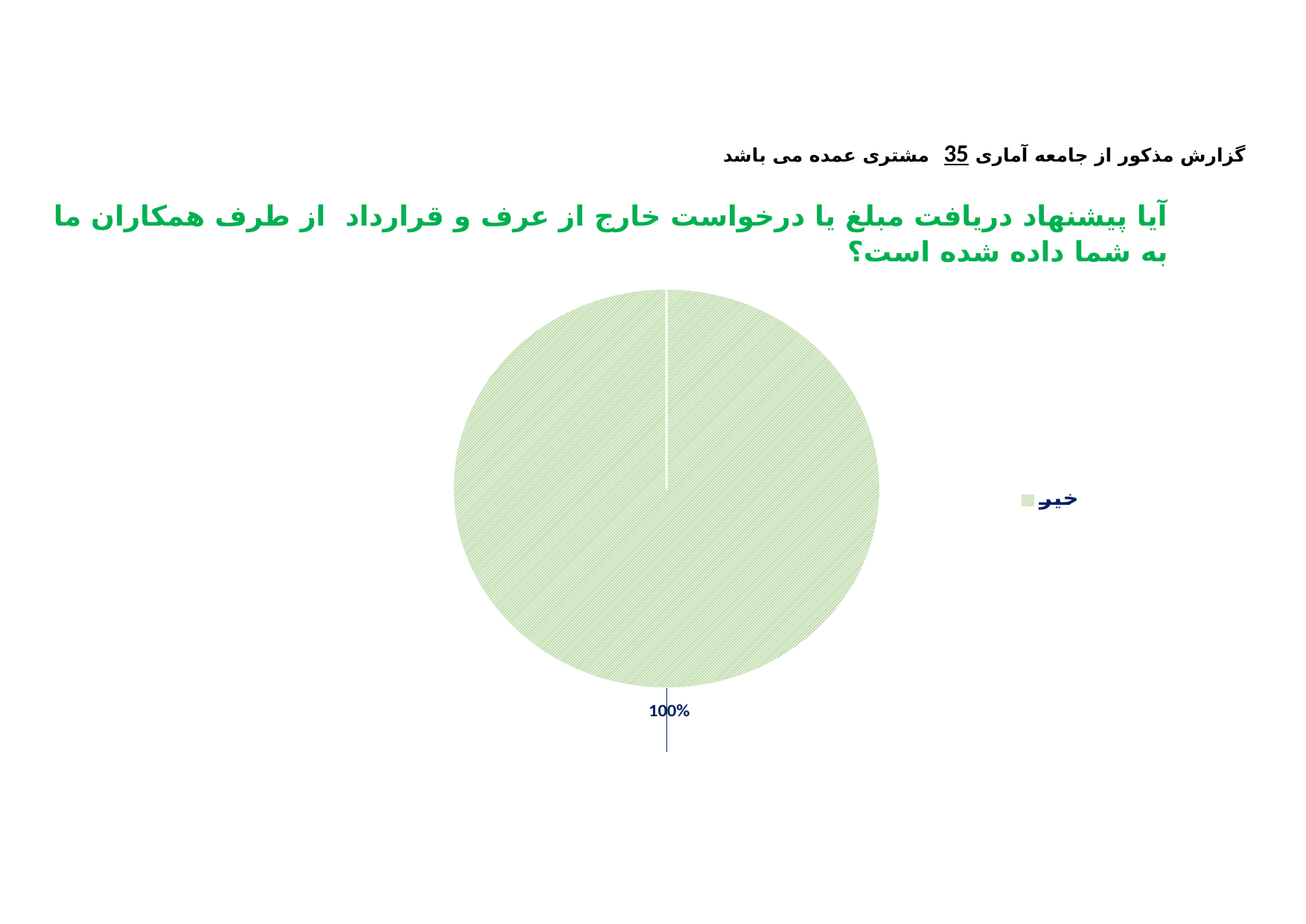
What share of the pie does the "خیر" slice take up? 100% What colour is the slice of the pie chart? light green How many entries does the legend of the pie chart list? 1 What percentage is shown for the "خیر" slice of the pie chart? 100% What kind of chart is shown on the slide? pie chart What is the only category listed in the legend of the pie chart? خیر Which category has the largest slice in the pie chart? خیر How many slices does the pie chart have? 1 Is the value for "خیر" greater or less than 50%? greater According to the text above the chart, how many major customers make up the statistical population? 35